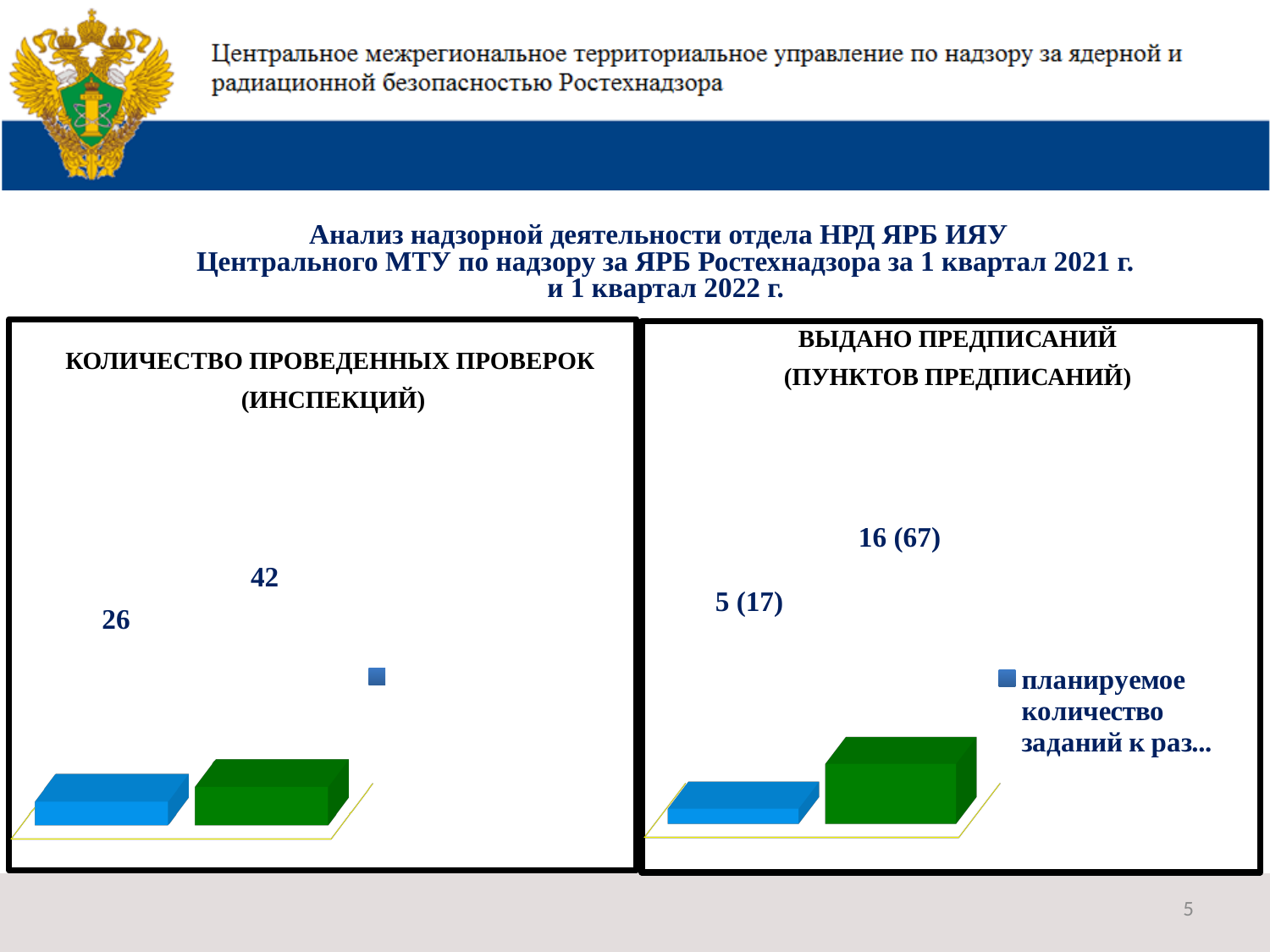
In the chart titled "ВЫДАНО ПРЕДПИСАНИЙ (ПУНКТОВ ПРЕДПИСАНИЙ)" on the right, what label is shown for the green bar? 16 (67) What type of chart is the right chart ("ВЫДАНО ПРЕДПИСАНИЙ")? bar chart In the right chart ("ВЫДАНО ПРЕДПИСАНИЙ"), which bar is higher, the blue one or the green one? the green one What is the title of the chart on the left side of the slide? КОЛИЧЕСТВО ПРОВЕДЕННЫХ ПРОВЕРОК (ИНСПЕКЦИЙ) In the chart titled "КОЛИЧЕСТВО ПРОВЕДЕННЫХ ПРОВЕРОК (ИНСПЕКЦИЙ)" on the left, what value is labelled on the green bar? 42 How many bars are plotted in the left chart ("КОЛИЧЕСТВО ПРОВЕДЕННЫХ ПРОВЕРОК")? 2 What type of chart is the left chart ("КОЛИЧЕСТВО ПРОВЕДЕННЫХ ПРОВЕРОК")? bar chart In the chart titled "КОЛИЧЕСТВО ПРОВЕДЕННЫХ ПРОВЕРОК (ИНСПЕКЦИЙ)" on the left, what value is labelled on the blue bar? 26 In the left chart ("КОЛИЧЕСТВО ПРОВЕДЕННЫХ ПРОВЕРОК"), what is the difference between the green bar's value and the blue bar's value? 16 In the left chart ("КОЛИЧЕСТВО ПРОВЕДЕННЫХ ПРОВЕРОК"), which bar is taller, the blue one or the green one? the green one In the chart titled "ВЫДАНО ПРЕДПИСАНИЙ (ПУНКТОВ ПРЕДПИСАНИЙ)" on the right, what label is shown for the blue bar? 5 (17) How many bars are plotted in the right chart ("ВЫДАНО ПРЕДПИСАНИЙ")? 2